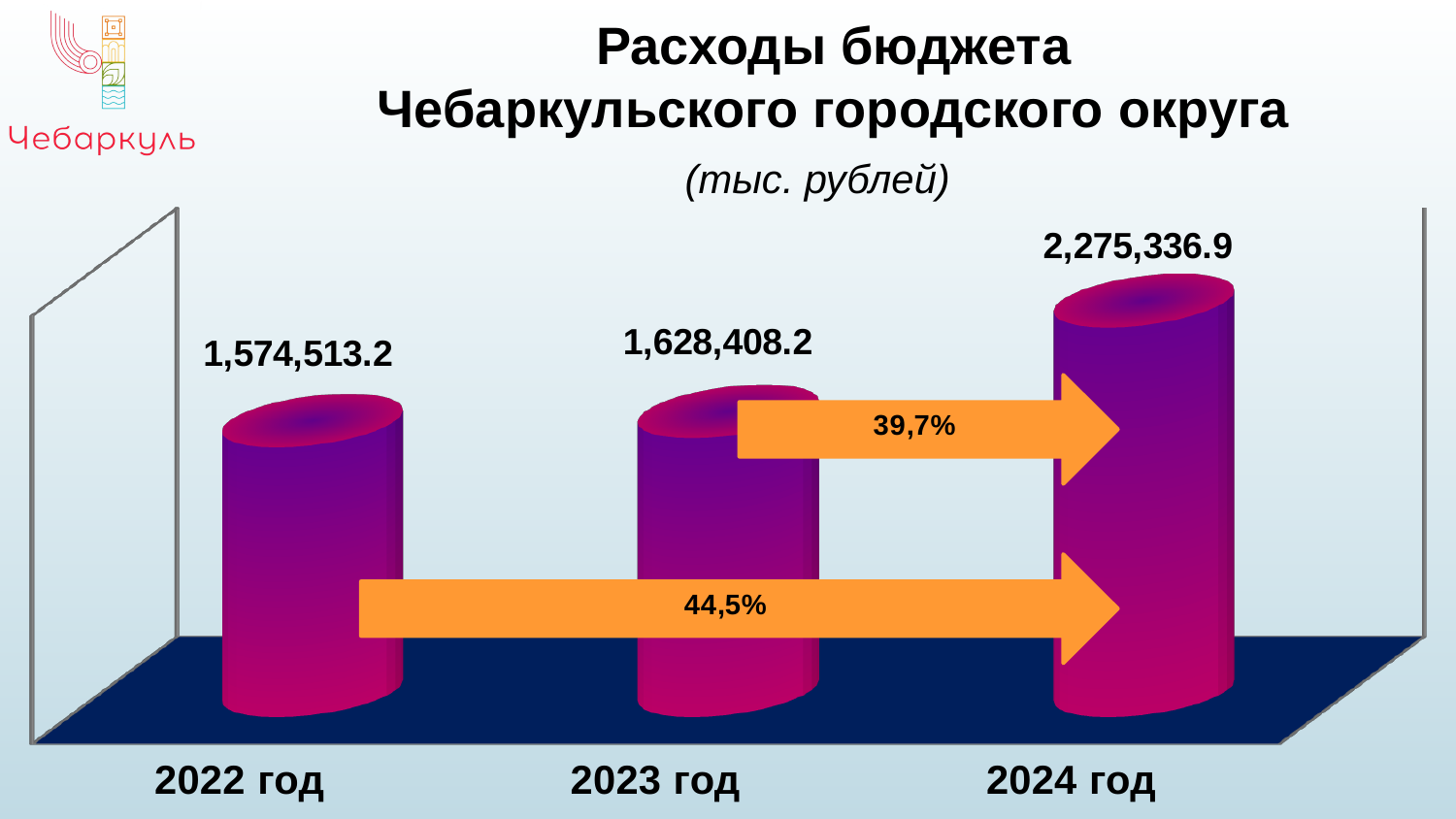
What kind of chart is shown on the slide? Bar chart Which is larger, the value for 2023 год or the value for 2022 год? 2023 год Which year has the highest budget expenditure? 2024 год What is the budget expenditure value shown for 2022 год? 1,574,513.2 What is the difference between the 2023 год and 2022 год values? 53,895.0 How many years (categories) are shown in the chart? 3 What is the budget expenditure value shown for 2023 год? 1,628,408.2 What is the difference between the 2024 год and 2023 год values? 646,928.7 Do the values rise or fall from 2022 год to 2024 год? Rise What is the budget expenditure value shown for 2024 год? 2,275,336.9 What percentage is shown on the arrow from 2022 год to 2024 год? 44,5% Which year has the lowest budget expenditure? 2022 год